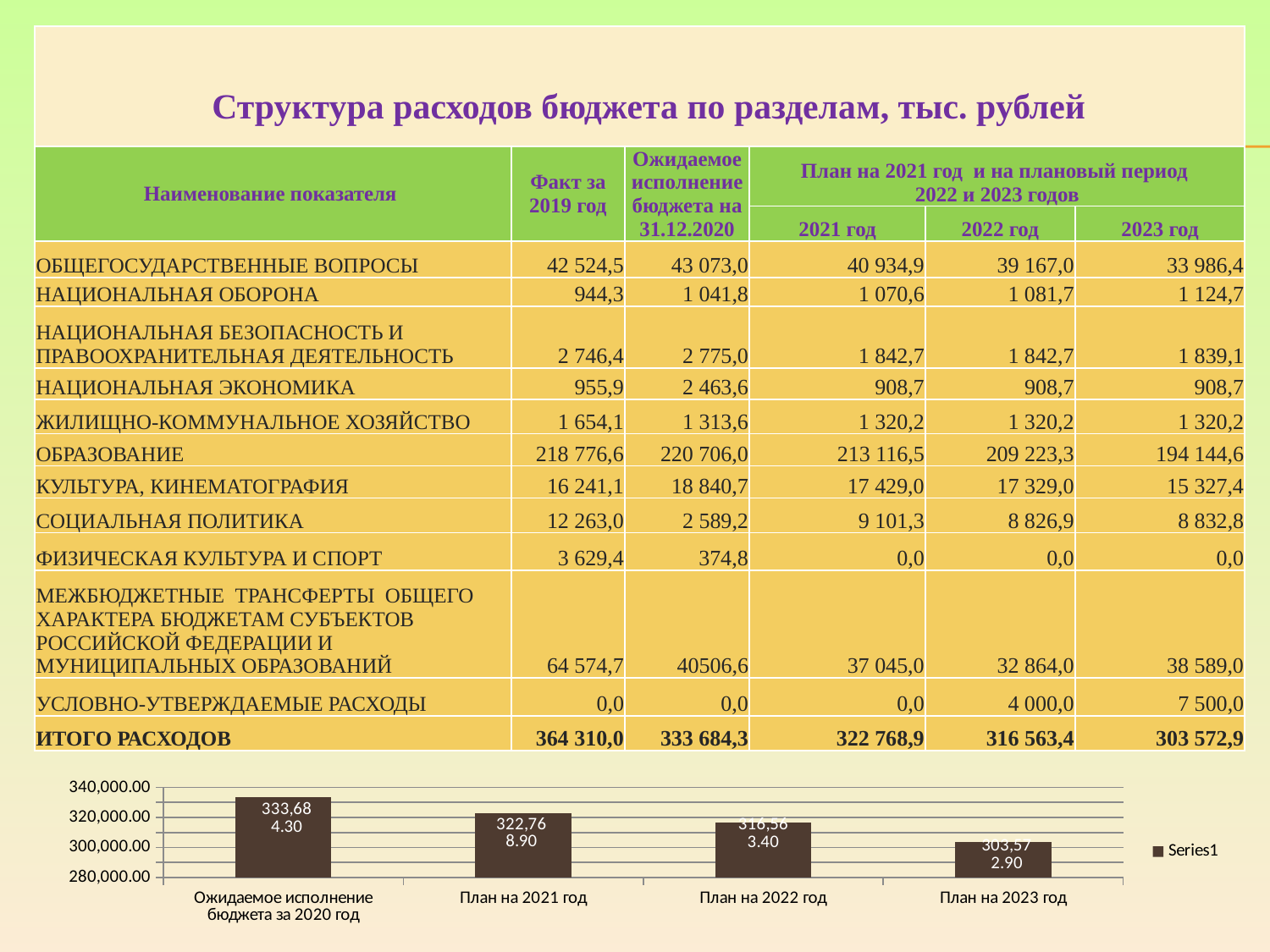
Is the value for 'План на 2022 год' greater or less than 300,000.00? greater Do the values in the chart rise or fall from left to right along the x axis? fall What is the value shown for 'План на 2023 год' in the chart? 303,572.90 Which category has the highest bar in the chart? Ожидаемое исполнение бюджета за 2020 год What is the difference between the values for 'Ожидаемое исполнение бюджета за 2020 год' and 'План на 2023 год' in the chart? 30,111.40 How many series does the chart legend list? 1 What is the value shown for 'Ожидаемое исполнение бюджета за 2020 год' in the chart? 333,684.30 What kind of chart is shown at the bottom of the slide? bar chart What is the value shown for 'План на 2021 год' in the chart? 322,768.90 Which is larger in the chart: 'План на 2021 год' or 'План на 2023 год'? План на 2021 год How many bars are plotted in the chart? 4 Which category has the lowest bar in the chart? План на 2023 год